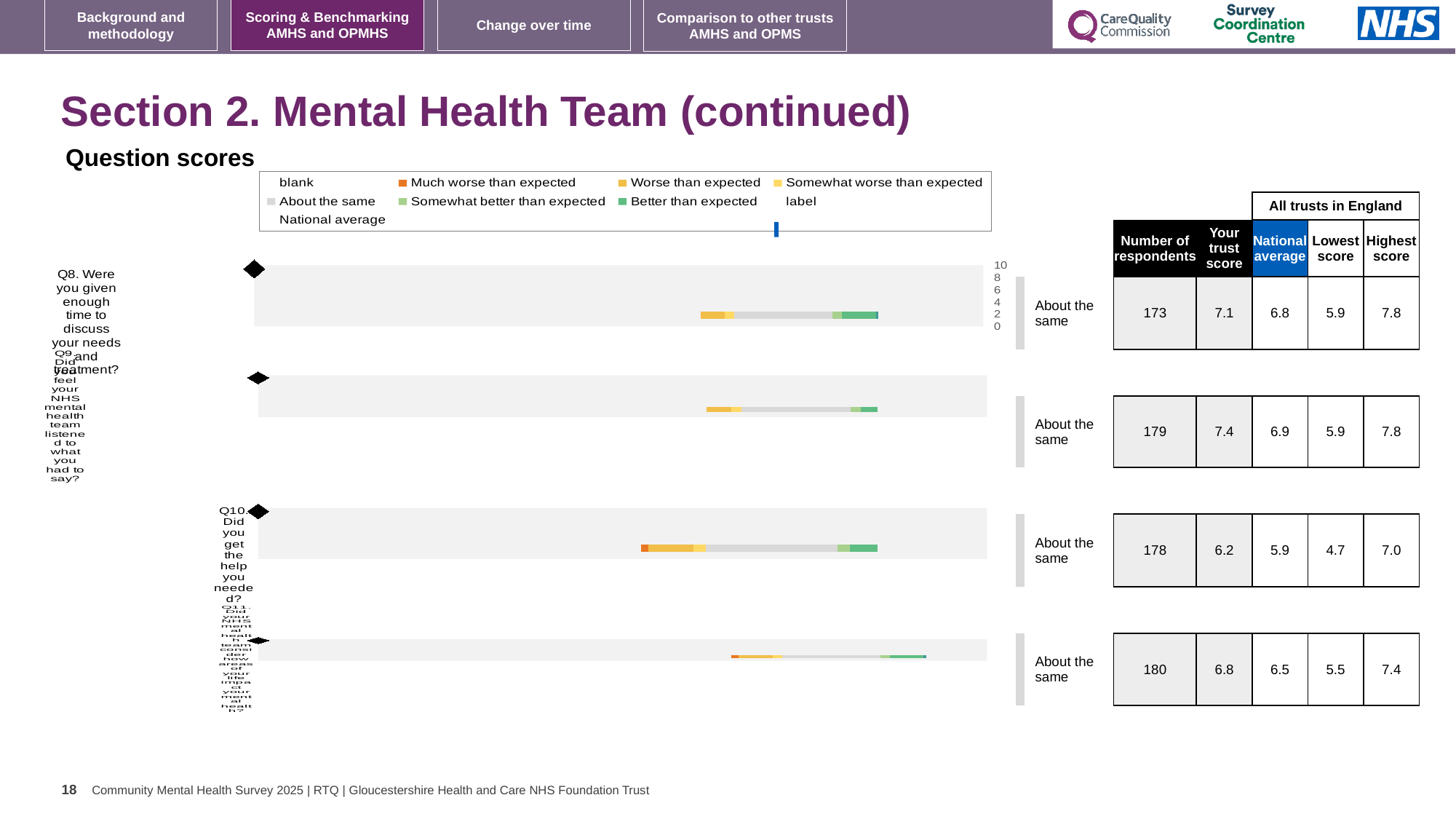
How many question score charts are shown on the slide? 4 For the Q10 chart, what is the lowest score among all trusts in England? 4.7 For the Q8 chart, what is the difference between the highest score and the lowest score among all trusts in England? 1.9 Which question chart has the highest 'Your trust score' value? Q9 For the Q8 chart, what is the 'Your trust score' value shown in the table? 7.1 In the chart legend, what colour is used for 'About the same'? grey For the Q8 chart, what is the number of respondents shown in the table? 173 For the Q9 chart, what is the national average shown in the table? 6.9 For the Q10 chart, which is larger: the trust score or the national average? the trust score (6.2) What kind of chart is used to show the Q8 question score? bar chart For the Q11 chart, what is the highest score among all trusts in England? 7.4 In the chart legend, which entry is shown in orange? Much worse than expected